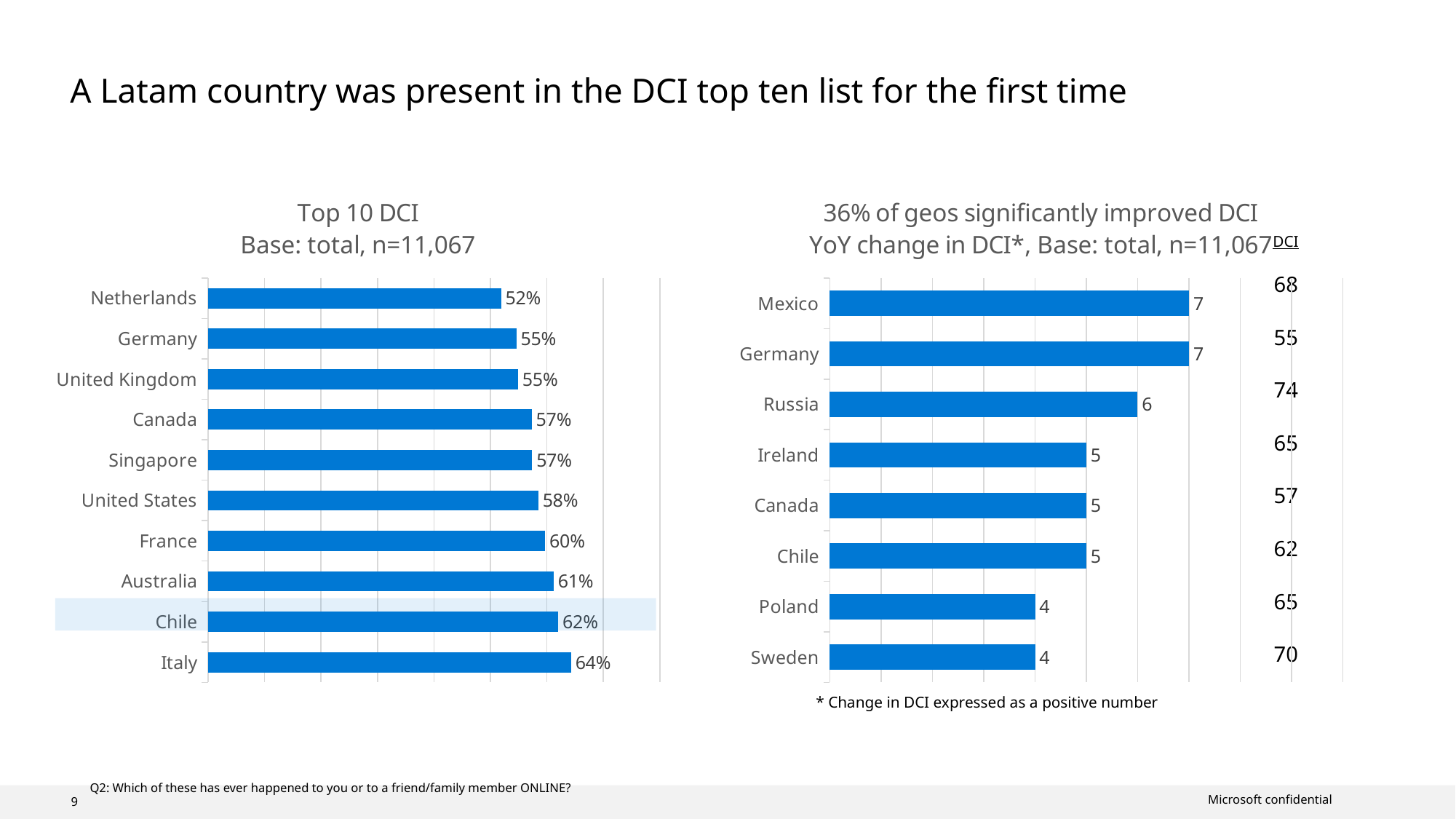
How many countries are shown in the '36% of geos significantly improved DCI' chart? 8 In the 'Top 10 DCI' chart, what is the value for the United States? 58% In the 'Top 10 DCI' chart, what is the difference between Italy and Netherlands? 12% In the 'Top 10 DCI' chart, which is larger, the value for France or the value for Canada? France In the 'Top 10 DCI' chart, what is the value for Chile? 62% What type of chart is the 'Top 10 DCI' chart? Bar chart In the 'Top 10 DCI' chart, which country has the lowest value? Netherlands How many countries are shown in the 'Top 10 DCI' chart? 10 In the 'Top 10 DCI' chart, which country has the highest value? Italy In the '36% of geos significantly improved DCI' chart, what is the YoY change for Mexico? 7 In the '36% of geos significantly improved DCI' chart, what is the YoY change for Russia? 6 In the '36% of geos significantly improved DCI' chart, what is the difference between Mexico and Sweden? 3